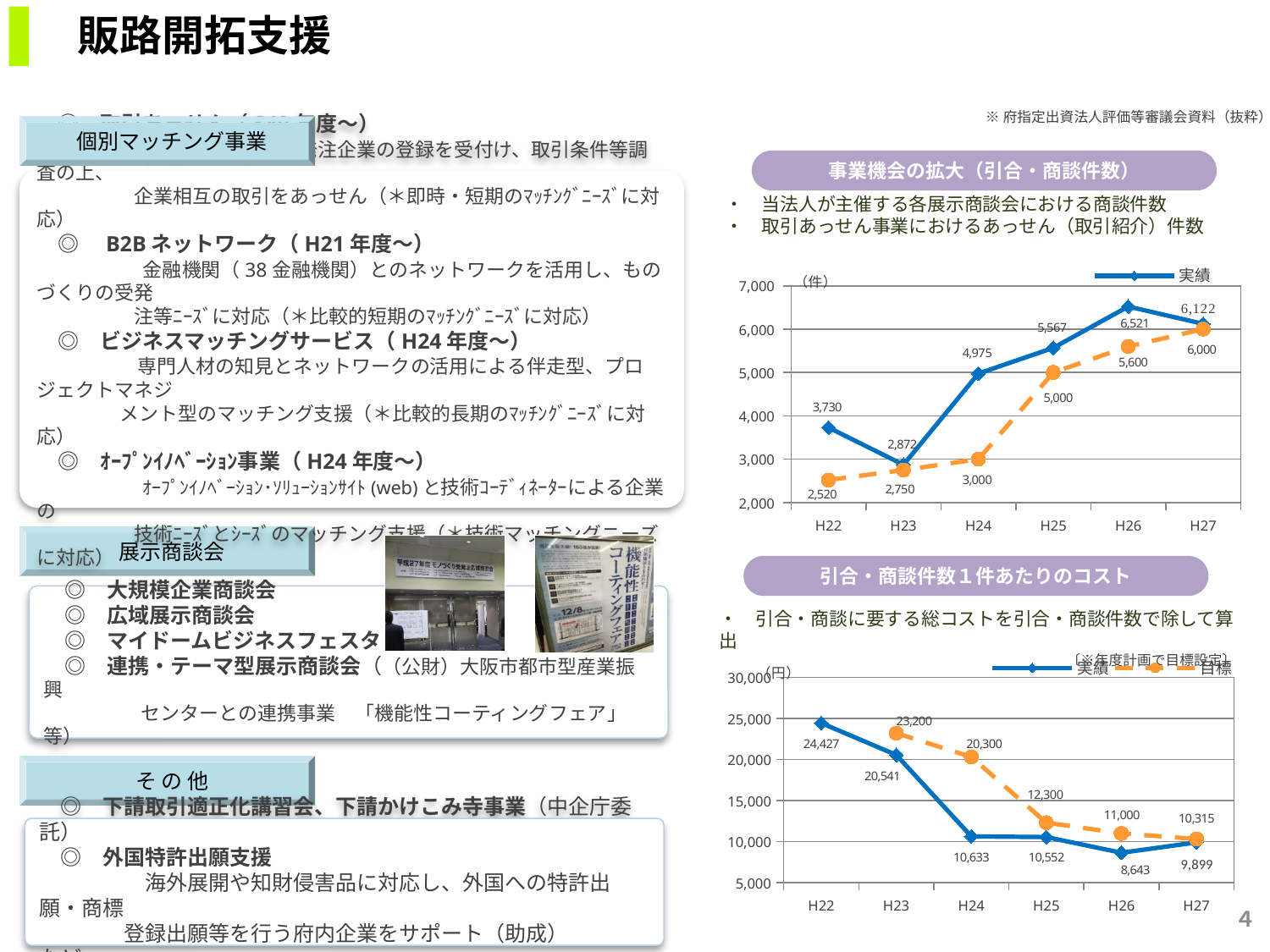
In the bottom chart 引合・商談件数1件あたりのコスト, is the 実績 value for H23 larger or smaller than the 目標 value for H23? Smaller In the top chart 事業機会の拡大（引合・商談件数）, what is the 実績 value for H26? 6,521 In the top chart 事業機会の拡大（引合・商談件数）, which year has the highest 実績 value? H26 In the bottom chart 引合・商談件数1件あたりのコスト, which year has the lowest 実績 value? H26 In the bottom chart 引合・商談件数1件あたりのコスト, what is the 目標 value for H27? 10,315 What type of chart is the top chart 事業機会の拡大（引合・商談件数）? Line chart In the top chart 事業機会の拡大（引合・商談件数）, what is the difference between the 実績 and 目標 values for H24? 1,975 In the bottom chart 引合・商談件数1件あたりのコスト, what is the 実績 value for H22? 24,427 How many series does the legend of the bottom chart 引合・商談件数1件あたりのコスト list? 2 In the top chart 事業機会の拡大（引合・商談件数）, which year has the lowest 実績 value? H23 In the top chart 事業機会の拡大（引合・商談件数）, how many years are shown on the x axis? 6 In the top chart 事業機会の拡大（引合・商談件数）, what is the 目標 value for H25? 5,000